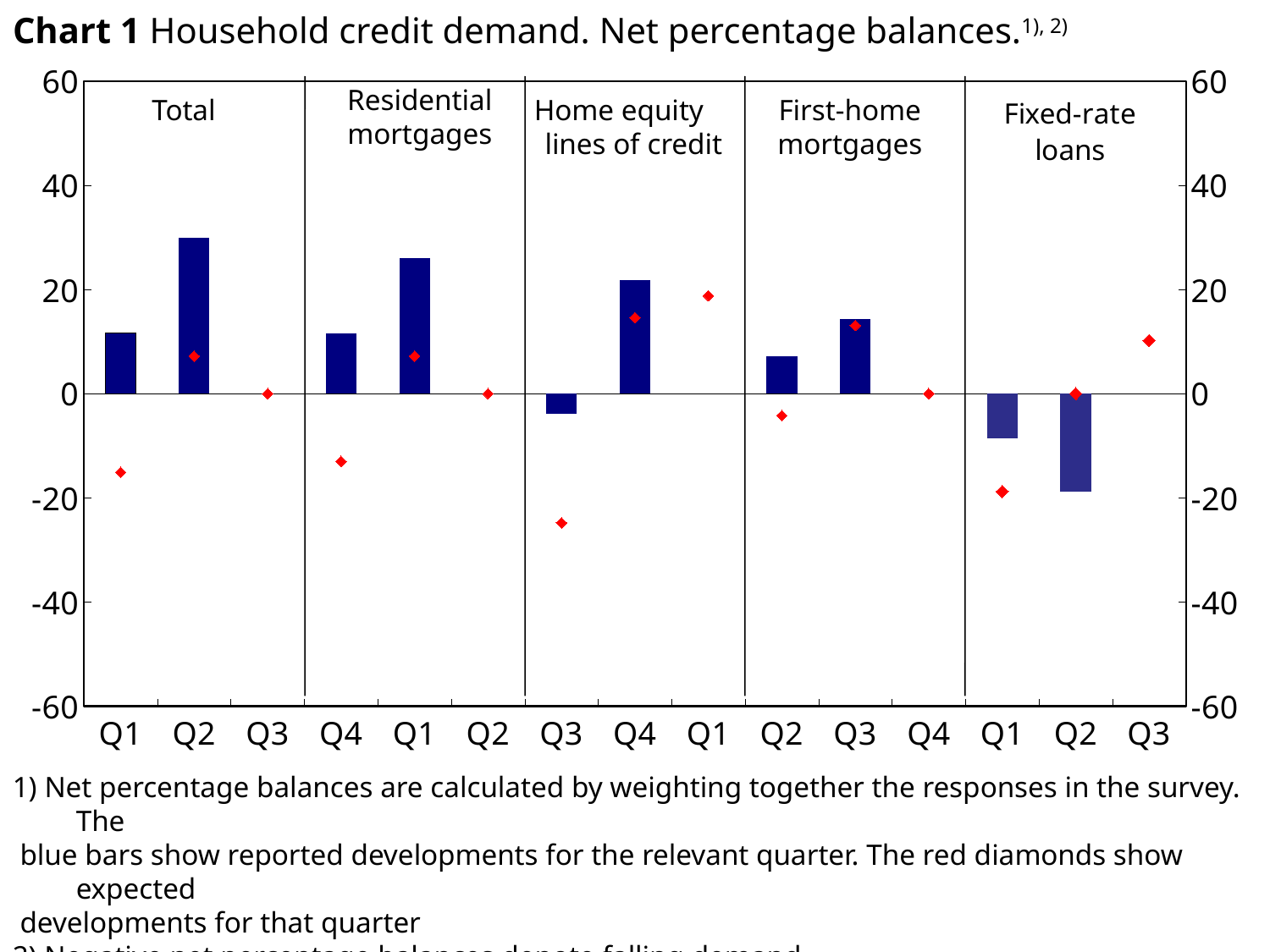
Which is larger: the Q4 bar in the Home equity lines of credit panel or the Q3 bar in the First-home mortgages panel? Q4 bar in Home equity lines of credit Which bar is the lowest (most negative) in the chart? Q2 in Fixed-rate loans In the Home equity lines of credit panel, is the red diamond for Q3 greater or less than -20? less According to the footnote, what do the red diamonds show? Expected developments for that quarter In the Total panel, which bar is taller, Q1 or Q2? Q2 How many credit categories (panels) are shown in the chart? 5 How many quarters are labelled on the x axis within each panel? 3 In the Total panel, is the bar for Q2 greater or less than 20? greater What kind of chart is Chart 1? bar chart In the Residential mortgages panel, is the bar for Q1 greater or less than 20? greater Which panel contains the tallest bar in the chart? Total